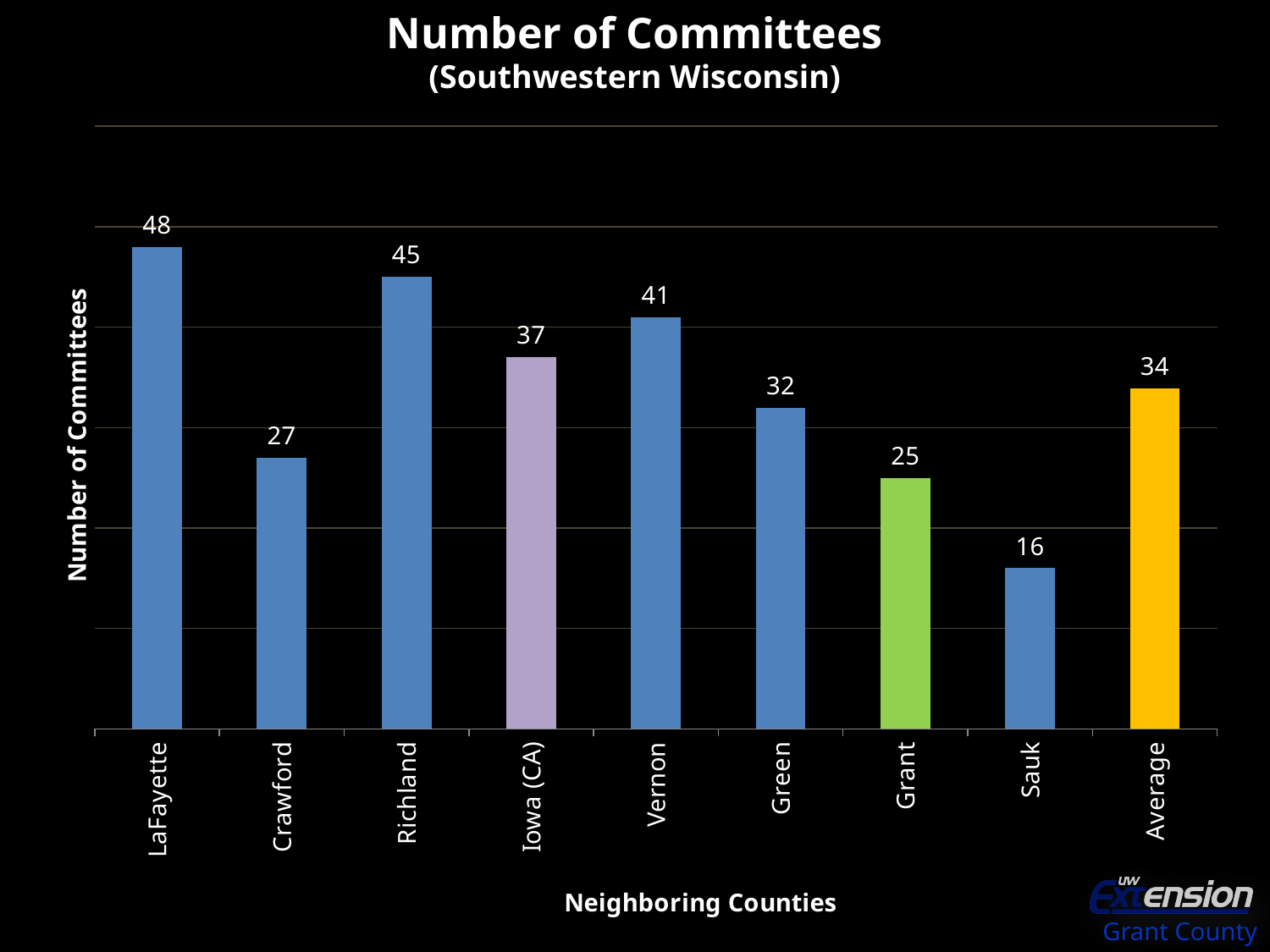
What value is shown for the Average bar? 34 What is the number of committees for Grant? 25 Which county has the highest number of committees? LaFayette What kind of chart is shown on the slide? Bar chart What is the title of the chart? Number of Committees (Southwestern Wisconsin) Which county has the lowest number of committees? Sauk Which has more committees, Vernon or Green? Vernon What is the label on the x axis? Neighboring Counties How many bars are plotted on the chart, including the Average bar? 9 What is the number of committees for Iowa (CA)? 37 What is the difference in number of committees between Richland and Crawford? 18 What is the number of committees for LaFayette? 48